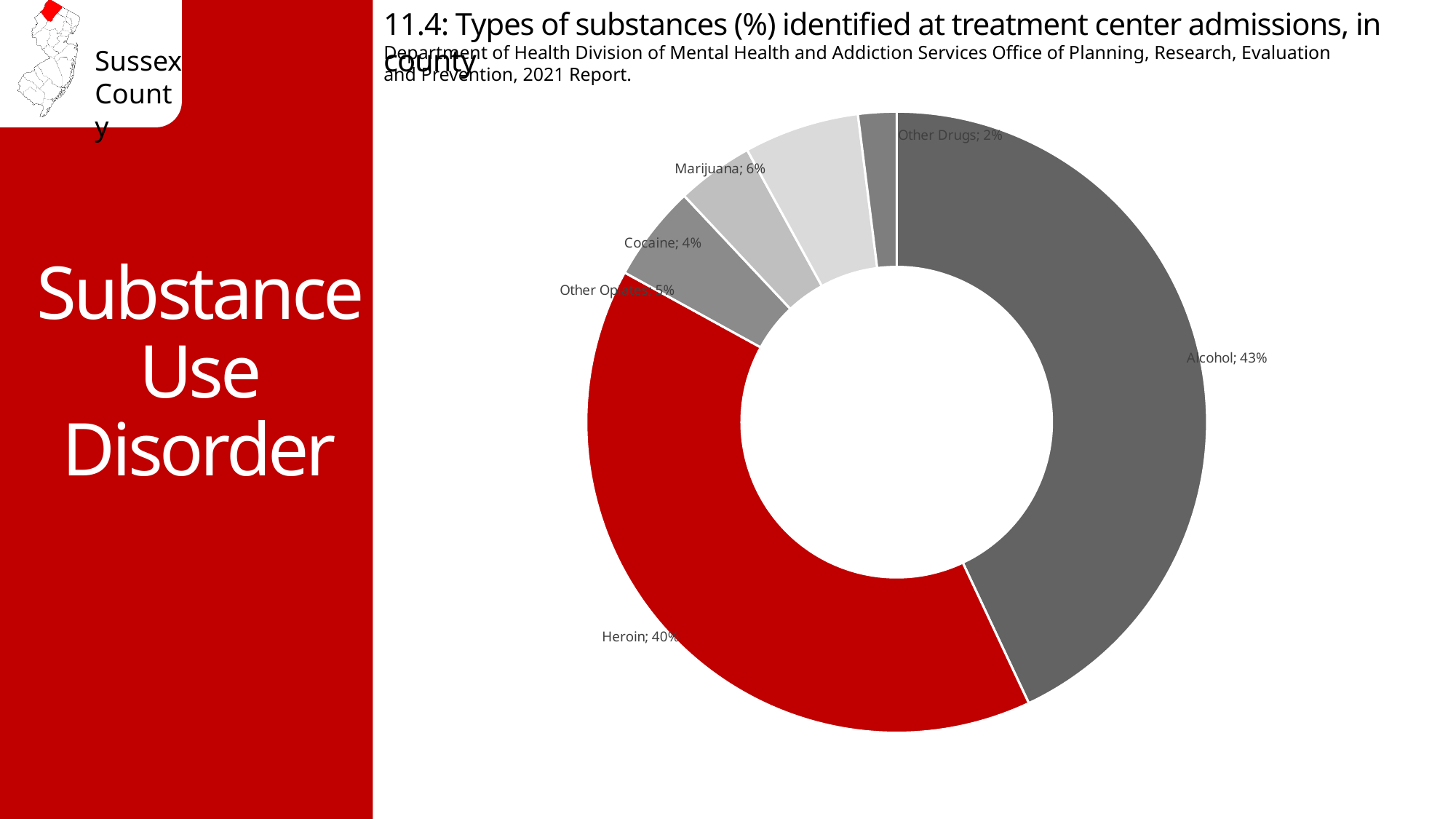
What is the difference in percentage points between Alcohol and Heroin? 3 How many substance categories are shown in the chart? 6 What percentage is shown for Marijuana? 6% What percentage is shown for Other Drugs? 2% What colour is the Heroin slice? Red Which substance has the smallest share of treatment center admissions? Other Drugs What percentage of treatment center admissions identified Alcohol? 43% Which has a larger share, Marijuana or Cocaine? Marijuana What kind of chart is used on this slide? Doughnut (pie) chart What percentage is shown for Cocaine? 4% What percentage of treatment center admissions identified Heroin? 40% Which substance has the largest share of treatment center admissions? Alcohol